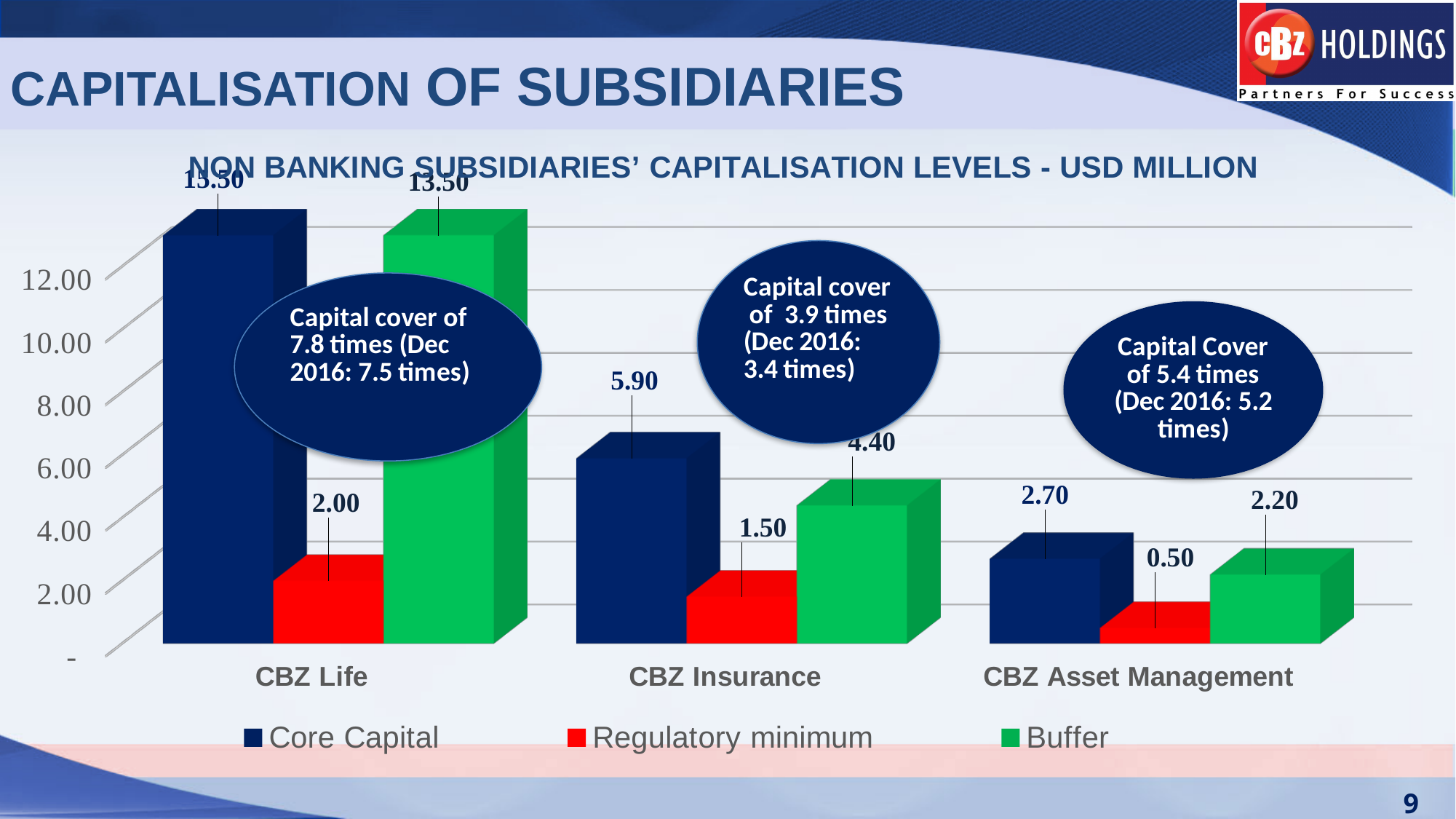
What is the difference between the Core Capital and the Regulatory minimum for CBZ Insurance? 4.40 Which colour represents the Buffer series in the chart? Green Which subsidiary has the highest Core Capital? CBZ Life What is the Buffer value for CBZ Asset Management? 2.20 What kind of chart is shown on the slide? Bar chart Which is larger for CBZ Life: the Core Capital or the Buffer? Core Capital Which subsidiary has the lowest Regulatory minimum? CBZ Asset Management How many series does the chart legend list? 3 What is the Regulatory minimum value for CBZ Life? 2.00 Is the Buffer value for CBZ Insurance greater or less than 4.00? greater What is the Core Capital value for CBZ Insurance? 5.90 How many subsidiaries are shown on the x axis of the chart? 3